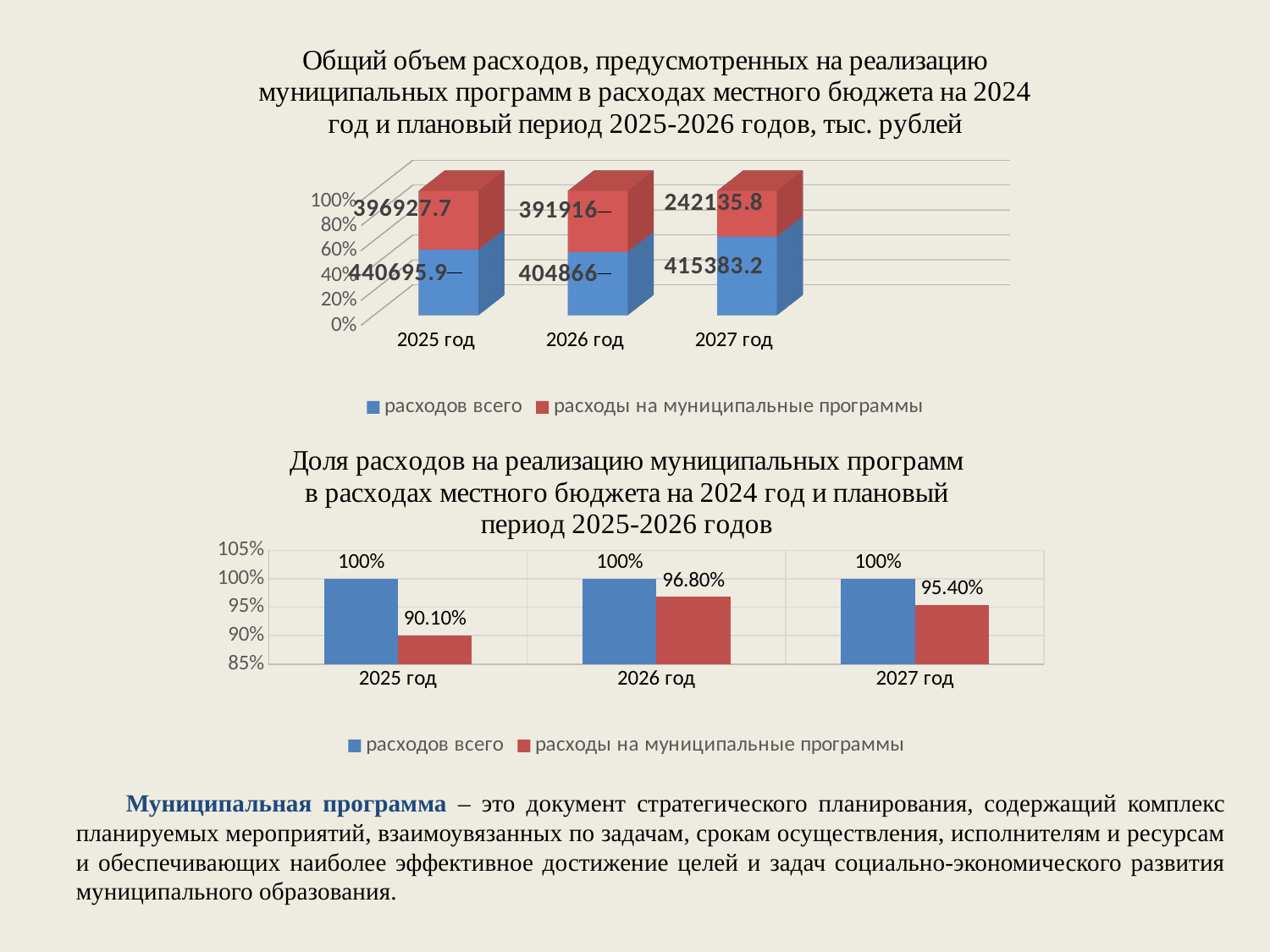
In the top chart, which year has the highest value for 'расходов всего'? 2025 год In the bottom chart, which year has the highest value for 'расходы на муниципальные программы'? 2026 год In the top chart, which year has the lowest value for 'расходы на муниципальные программы'? 2027 год In the top chart, how many series does the legend list? 2 In the top chart, what is the difference between 'расходов всего' and 'расходы на муниципальные программы' in 2026 год? 12950 What kind of chart is the bottom chart? bar chart In the bottom chart, is the value for 'расходы на муниципальные программы' in 2027 год greater or less than 95%? greater In the bottom chart, what is the value for 'расходы на муниципальные программы' in 2025 год? 90.10% In the top chart, what is the value for 'расходы на муниципальные программы' in 2026 год? 391916 In the top chart, what is the value for 'расходов всего' in 2025 год? 440695.9 In the bottom chart, how many categories are shown on the x axis? 3 In the top chart, what is the value for 'расходы на муниципальные программы' in 2027 год? 242135.8